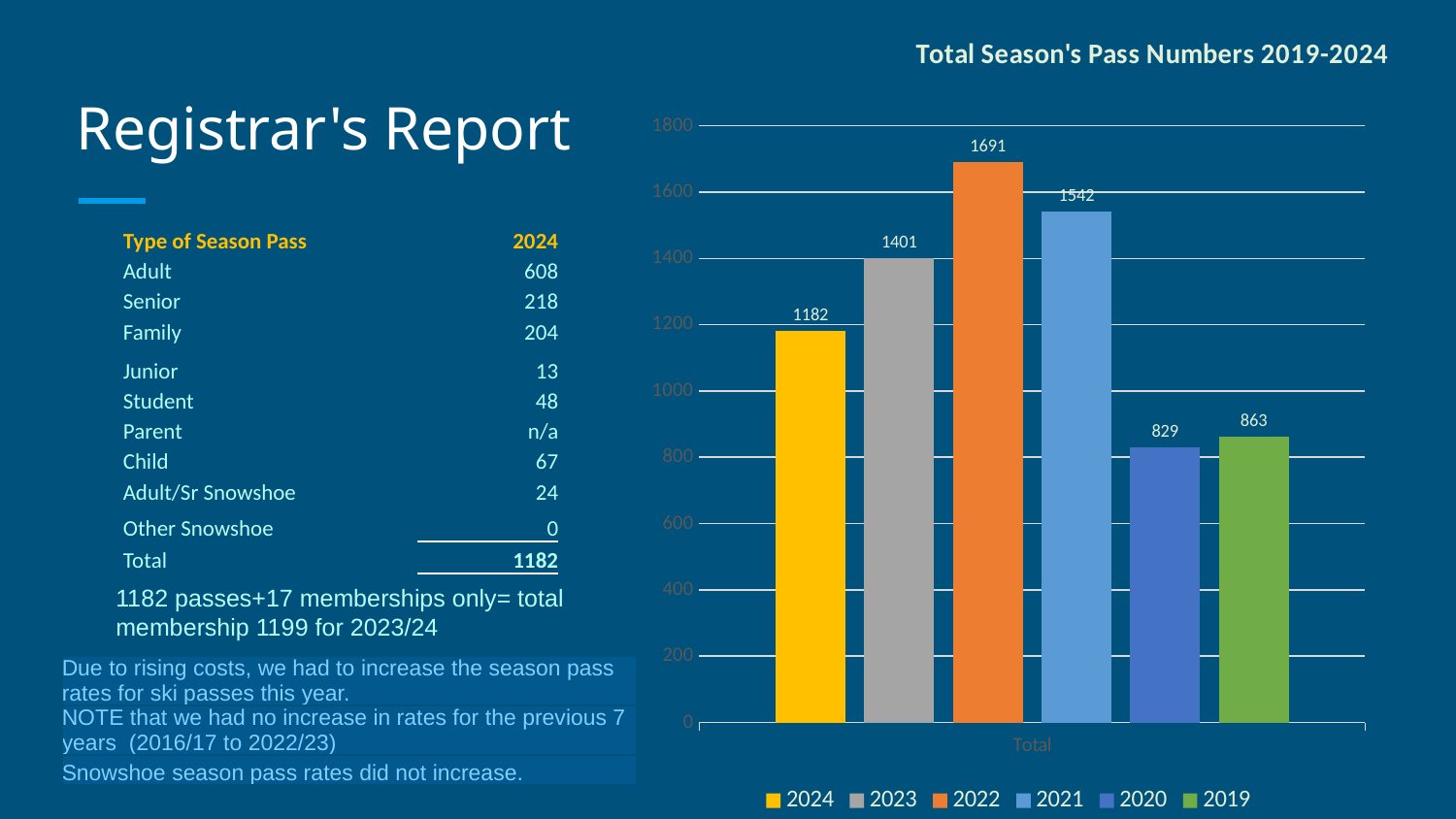
What is the difference between the 2023 and 2024 values? 219 Which year has the highest total season's pass number? 2022 What is the value for 2022 in the Total Season's Pass Numbers chart? 1691 Which year has the lowest total season's pass number? 2020 What is the difference between the 2022 and 2021 values? 149 What kind of chart is shown on the slide? bar chart What is the value for 2024 in the Total Season's Pass Numbers chart? 1182 What is the value for 2020 in the Total Season's Pass Numbers chart? 829 How many series does the legend list? 6 Is the value for 2021 greater or less than 1400? greater What is the title of the chart? Total Season's Pass Numbers 2019-2024 Which is larger, the value for 2019 or the value for 2020? 2019